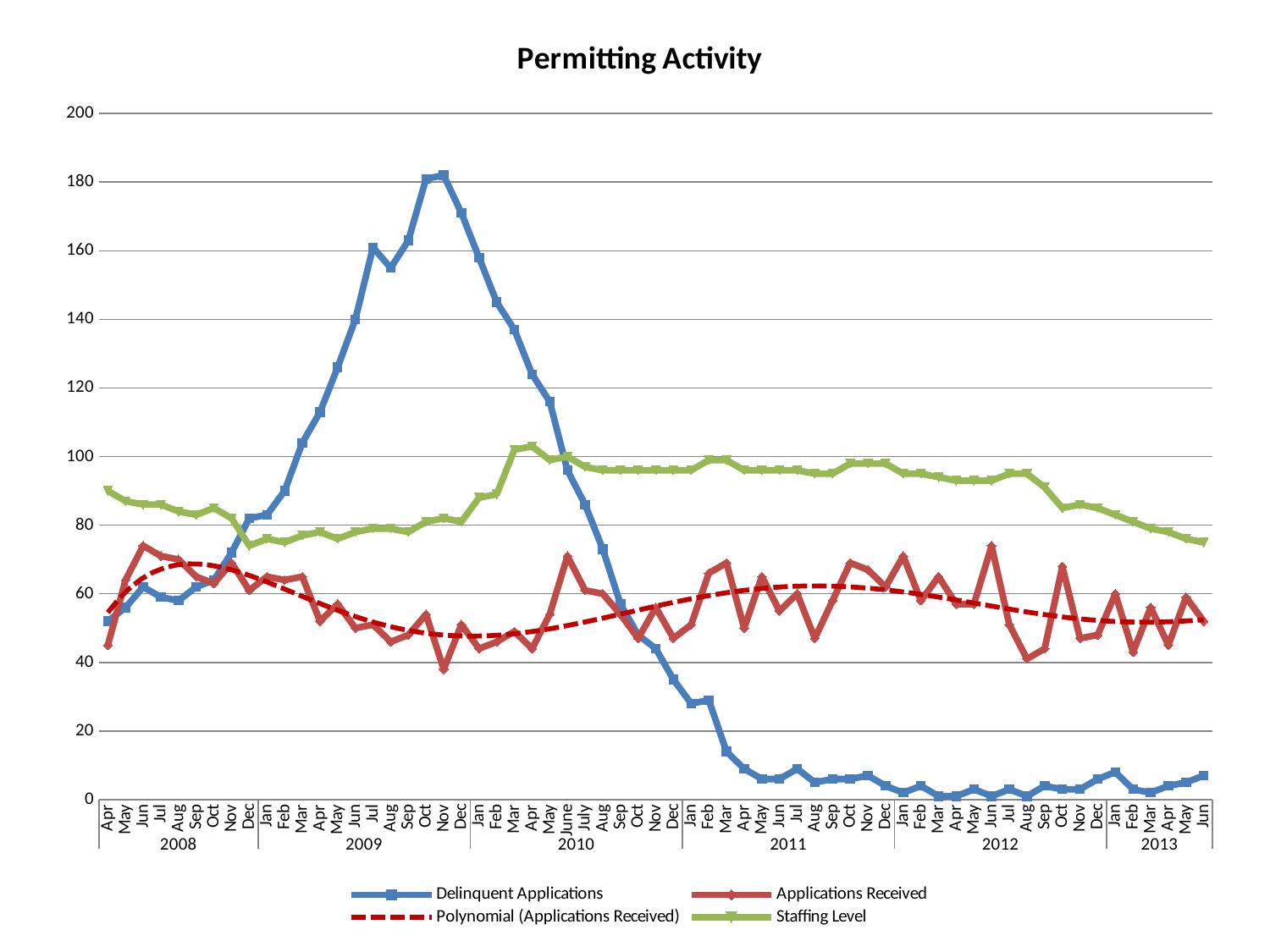
Is the value for Staffing Level in Apr 2010 greater or less than 100? greater Which series in the legend is drawn as a dashed line? Polynomial (Applications Received) What is the title of the chart? Permitting Activity In which year does the Delinquent Applications series reach its highest point? 2009 What kind of chart is shown on the slide? line chart Is the value for Applications Received in Jun 2008 greater or less than 60? greater Is the value for Delinquent Applications in Nov 2009 greater or less than 160? greater Does the Staffing Level series rise or fall from Jan 2013 to Jun 2013? fall How many series does the legend list? 4 In Apr 2008, which is higher: Delinquent Applications or Staffing Level? Staffing Level In Jun 2013, which is higher: Staffing Level or Delinquent Applications? Staffing Level